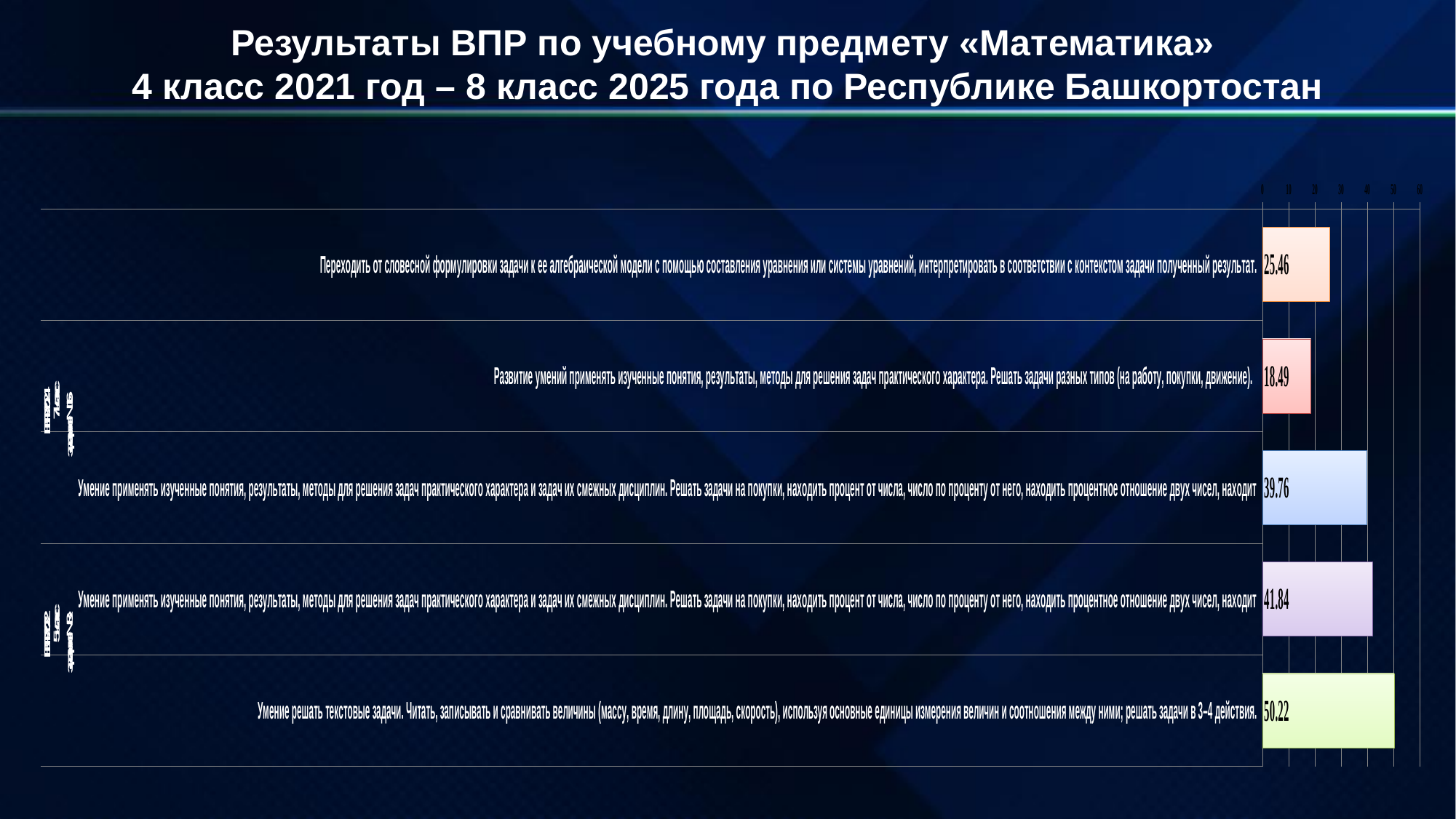
What value is shown on the fourth bar from the top of the chart? 41.84 What value is shown for the bar labelled "Переходить от словесной формулировки задачи к ее алгебраической модели..."? 25.46 What is the difference between the fourth bar from the top (41.84) and the third bar from the top (39.76)? 2.08 What is the difference between the highest value (50.22) and the lowest value (18.49) in the chart? 31.73 How many bars are plotted in the chart? 5 Which category has the lowest value in the chart? Развитие умений применять изученные понятия, результаты, методы для решения задач практического характера... (18.49) What value is shown for the bar labelled "Умение решать текстовые задачи. Читать, записывать и сравнивать величины..."? 50.22 What type of chart is shown on the slide? Bar chart What value is shown on the third bar from the top of the chart? 39.76 Which category has the highest value in the chart? Умение решать текстовые задачи. Читать, записывать и сравнивать величины... (50.22) What value is shown for the bar labelled "Развитие умений применять изученные понятия, результаты, методы для решения задач практического характера..."? 18.49 Which is larger: the value for "Переходить от словесной формулировки задачи..." or the value for "Развитие умений применять изученные понятия..."? Переходить от словесной формулировки задачи... (25.46)